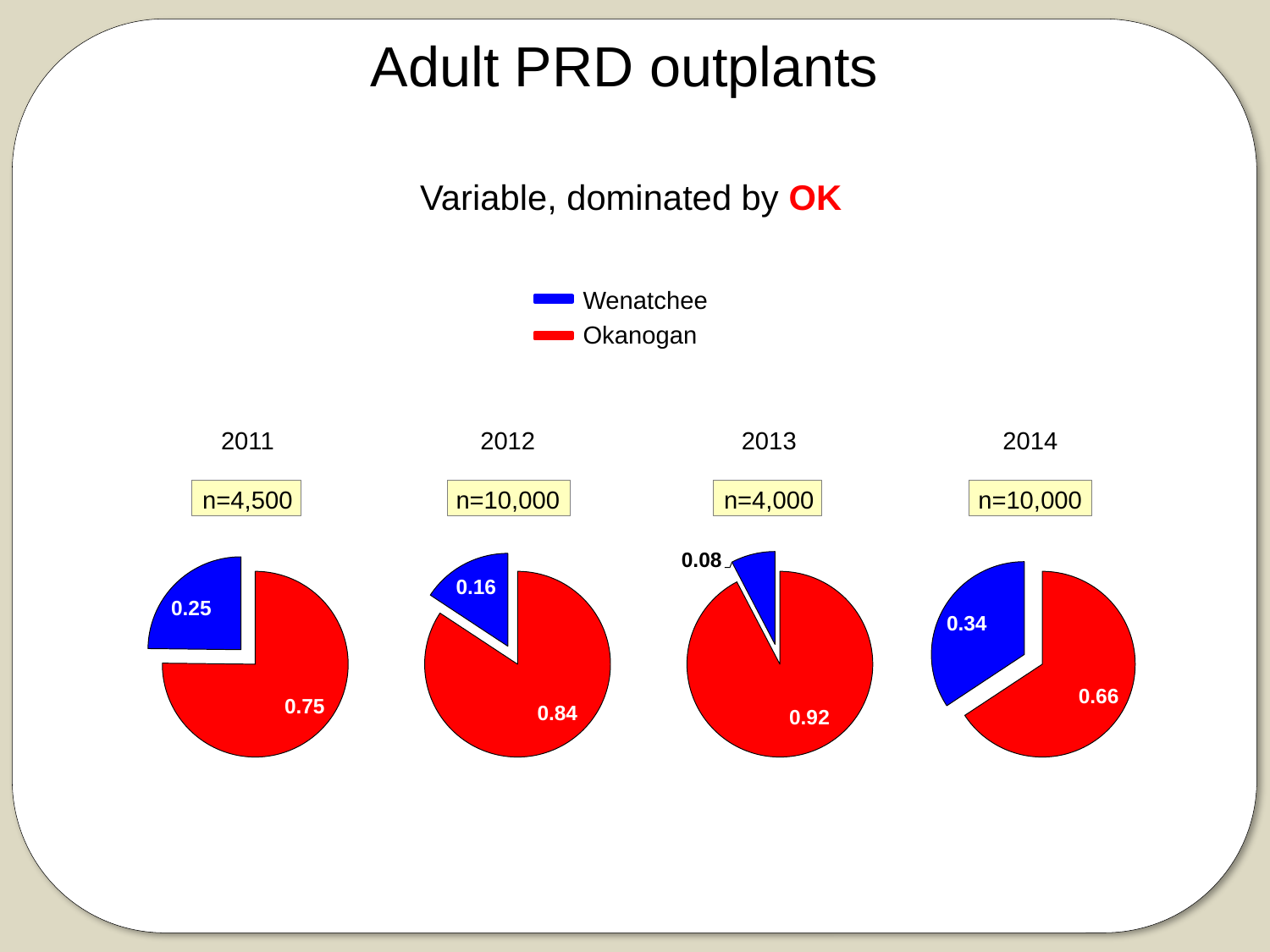
In the 2013 pie chart, what is the value for Wenatchee? 0.08 What is the sample size (n) shown for the 2013 pie chart? n=4,000 In the 2011 pie chart, what is the value for Okanogan? 0.75 Across the four pie charts, which year has the lowest value for Wenatchee? 2013 In the 2012 pie chart, what is the value for Wenatchee? 0.16 In the 2011 pie chart, which is larger, Wenatchee or Okanogan? Okanogan Across the four pie charts, which year has the highest value for Okanogan? 2013 How many pie charts are shown on the slide? 4 In the 2014 pie chart, what is the difference between the Okanogan and Wenatchee values? 0.32 What kind of chart is used for each year on the slide? Pie chart In the 2014 pie chart, what is the value for Okanogan? 0.66 How many series does the legend list? 2